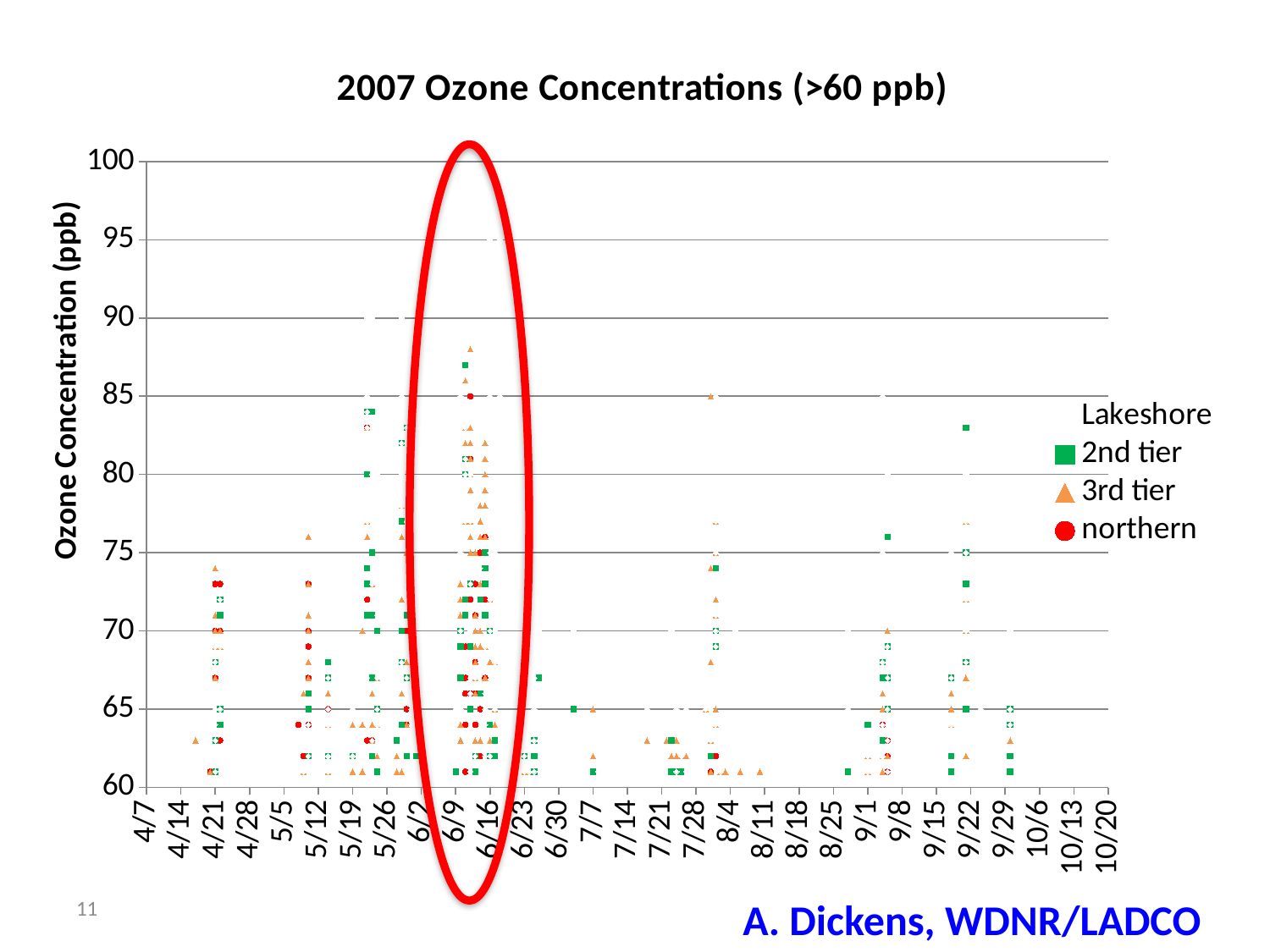
What is the label of the vertical axis? Ozone Concentration (ppb) What is the title of the chart? 2007 Ozone Concentrations (>60 ppb) Is the highest northern value on the chart greater or less than 90? less Is the highest plotted value on the chart greater or less than 85? greater Is the highest 2nd tier value plotted near 9/22 greater or less than 80? greater How many series does the legend list? 4 What kind of chart is shown on the slide? scatter chart